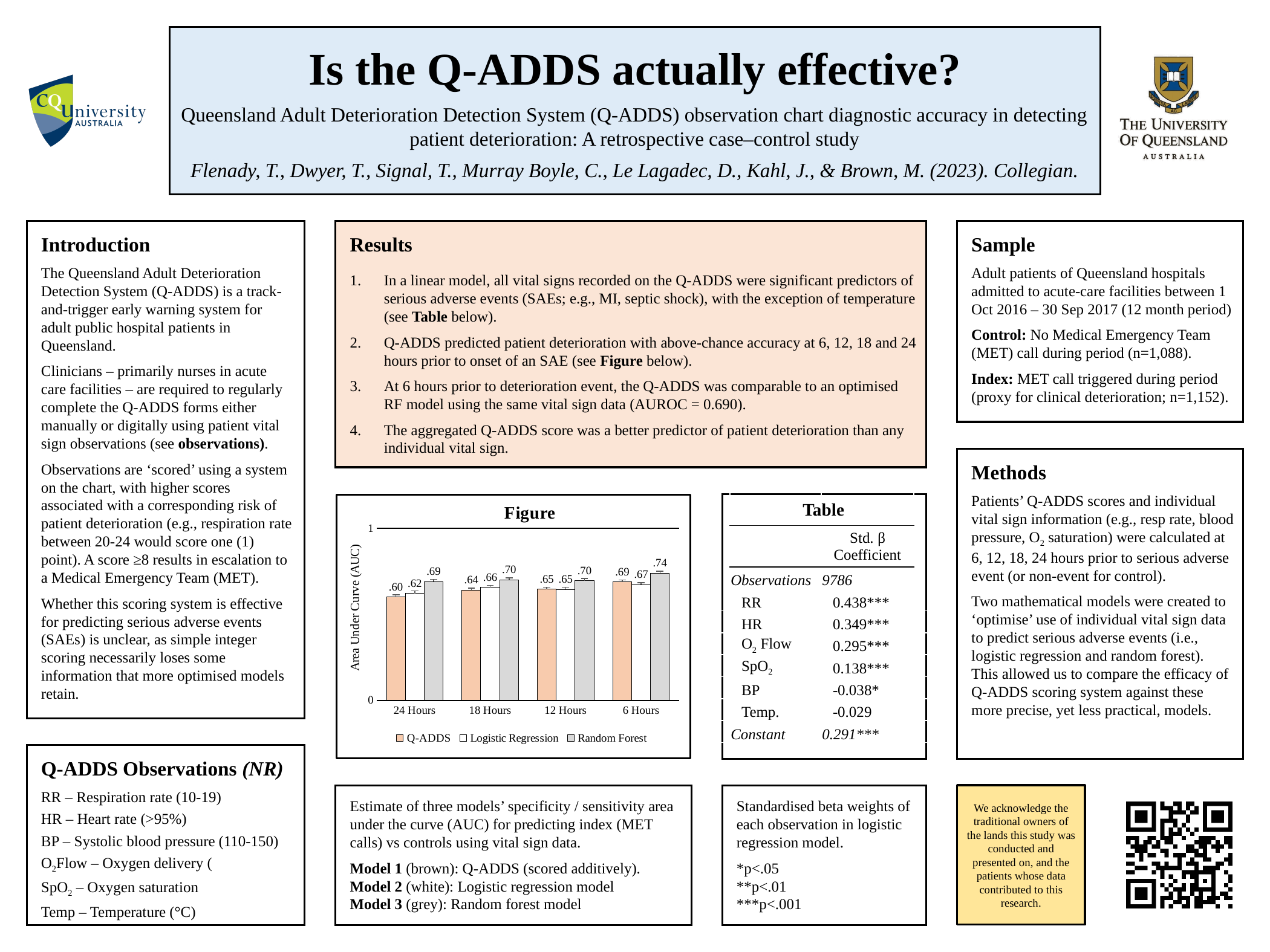
What is the y-axis label of the Figure? Area Under Curve (AUC) In the Figure, what is the AUC value for Random Forest at 6 Hours? .74 How many series does the legend of the Figure list? 3 In the Figure, does the Q-ADDS AUC rise or fall from 24 Hours to 6 Hours? rise How many time-point categories are shown on the x axis of the Figure? 4 In the Figure, at which time point does Q-ADDS have its highest AUC? 6 Hours In the Figure, what is the AUC value for Logistic Regression at 18 Hours? .66 In the Figure, at which time point does Q-ADDS have its lowest AUC? 24 Hours In the Figure, which is larger at 6 Hours: the Q-ADDS AUC or the Logistic Regression AUC? Q-ADDS What type of chart is the Figure on the slide? bar chart In the Figure, what is the AUC value for Q-ADDS at 24 Hours? .60 In the Figure, what is the difference between the Random Forest and Q-ADDS AUC values at 24 Hours? .09